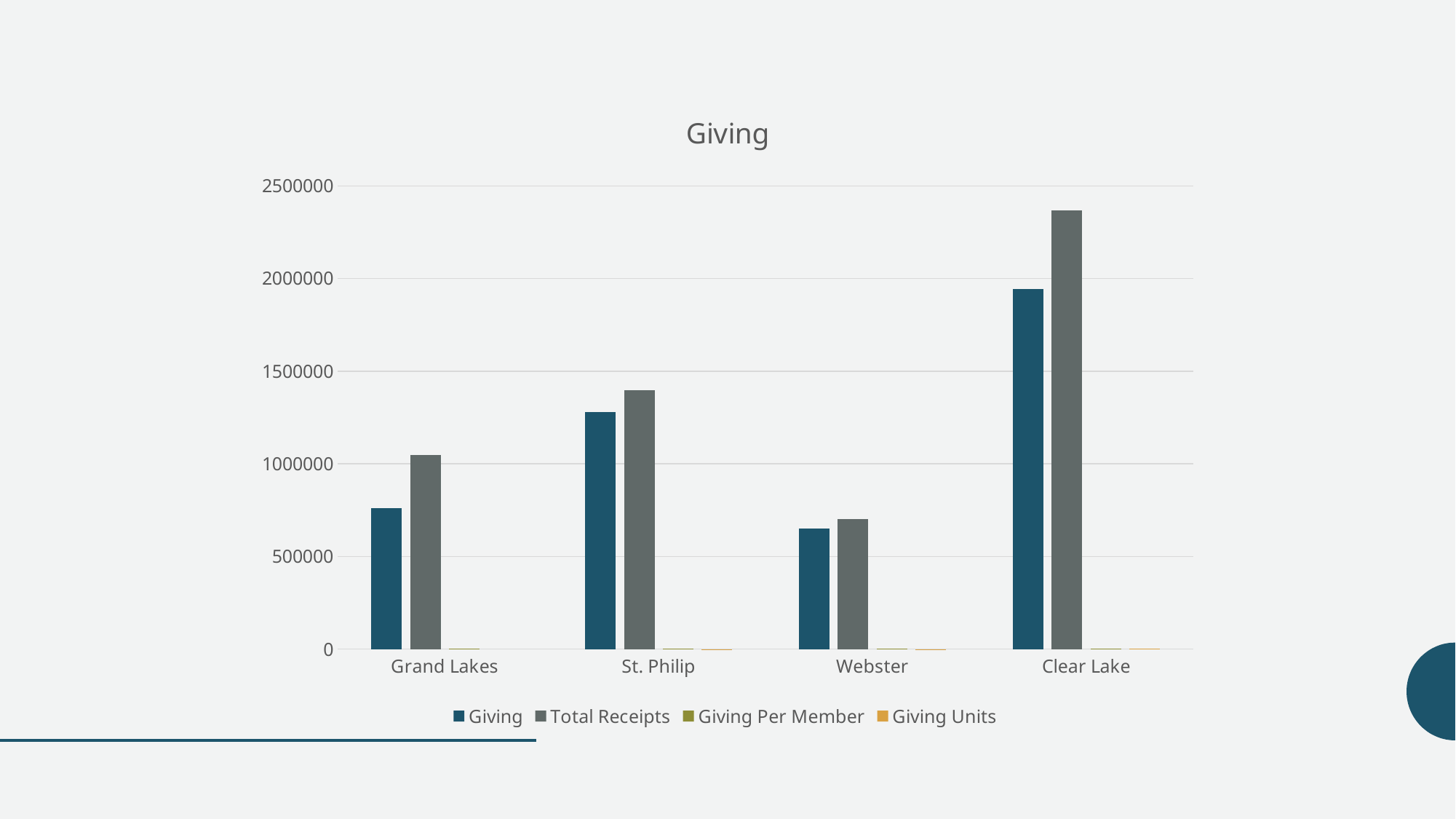
Which category has the lowest Total Receipts value? Webster What is the title of the chart? Giving Is the Total Receipts value for St. Philip greater or less than 1500000? less Which category has the highest Giving value? Clear Lake Is the Giving value for Grand Lakes greater or less than 1000000? less For Grand Lakes, which is larger: Giving or Total Receipts? Total Receipts How many categories are shown on the x axis? 4 Which is larger: the Giving value for St. Philip or the Total Receipts value for Grand Lakes? Giving for St. Philip What kind of chart is shown on the slide? bar chart Is the Giving value for St. Philip greater or less than 1000000? greater How many series does the legend list? 4